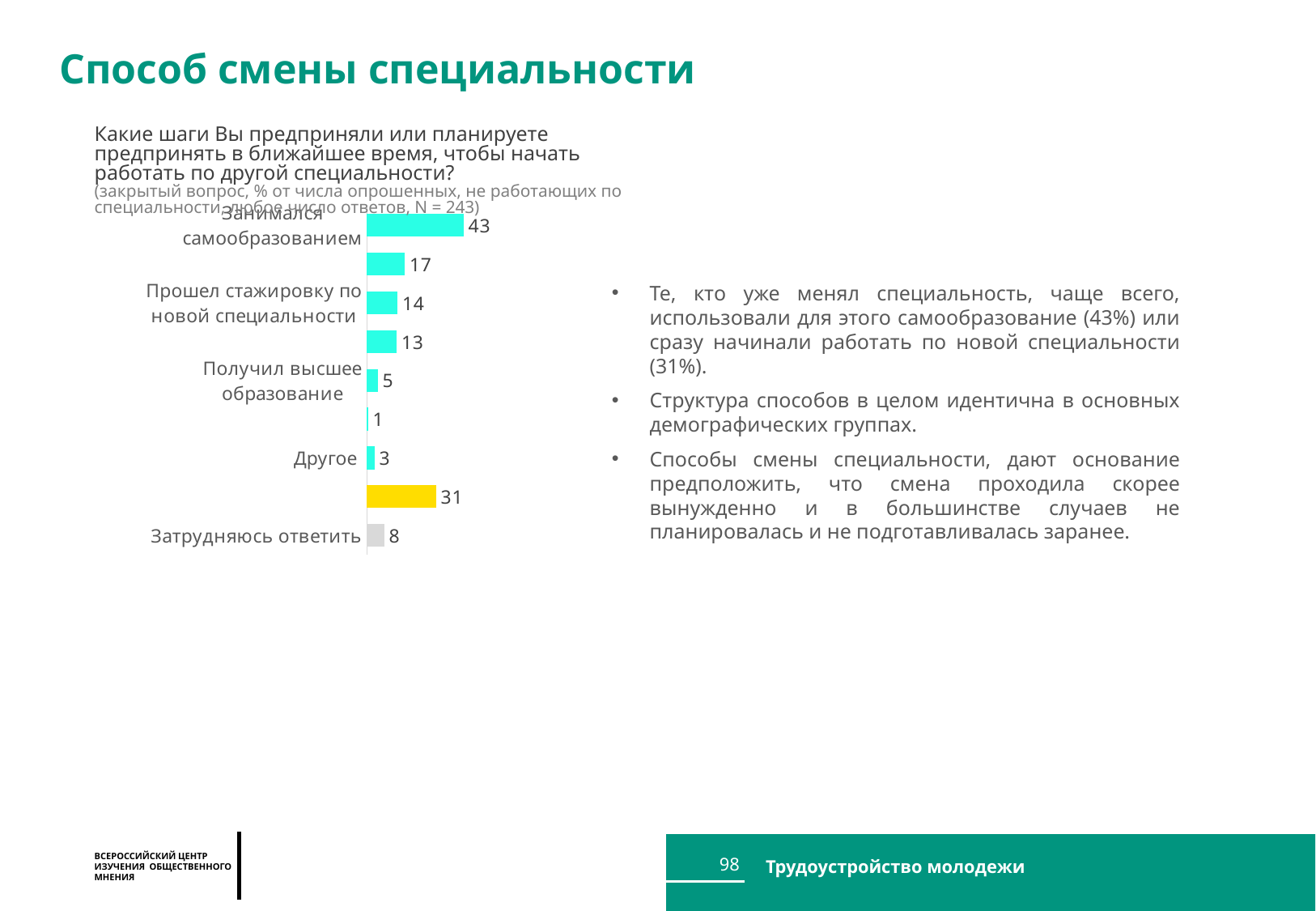
How many bars does the chart contain? 9 What value is shown for "Затрудняюсь ответить"? 8 Which is larger: the value for "Затрудняюсь ответить" or the value for "Получил высшее образование"? Затрудняюсь ответить Which labelled category has the highest value? Занимался самообразованием What kind of chart is shown on the slide? Bar chart What value is shown for "Прошел стажировку по новой специальности"? 14 What is the difference between the values for "Затрудняюсь ответить" and "Другое"? 5 What value is shown for "Получил высшее образование"? 5 What value is shown for "Другое"? 3 What value is shown on the yellow bar? 31 What is the difference between the values for "Занимался самообразованием" and "Прошел стажировку по новой специальности"? 29 What value is shown for "Занимался самообразованием"? 43